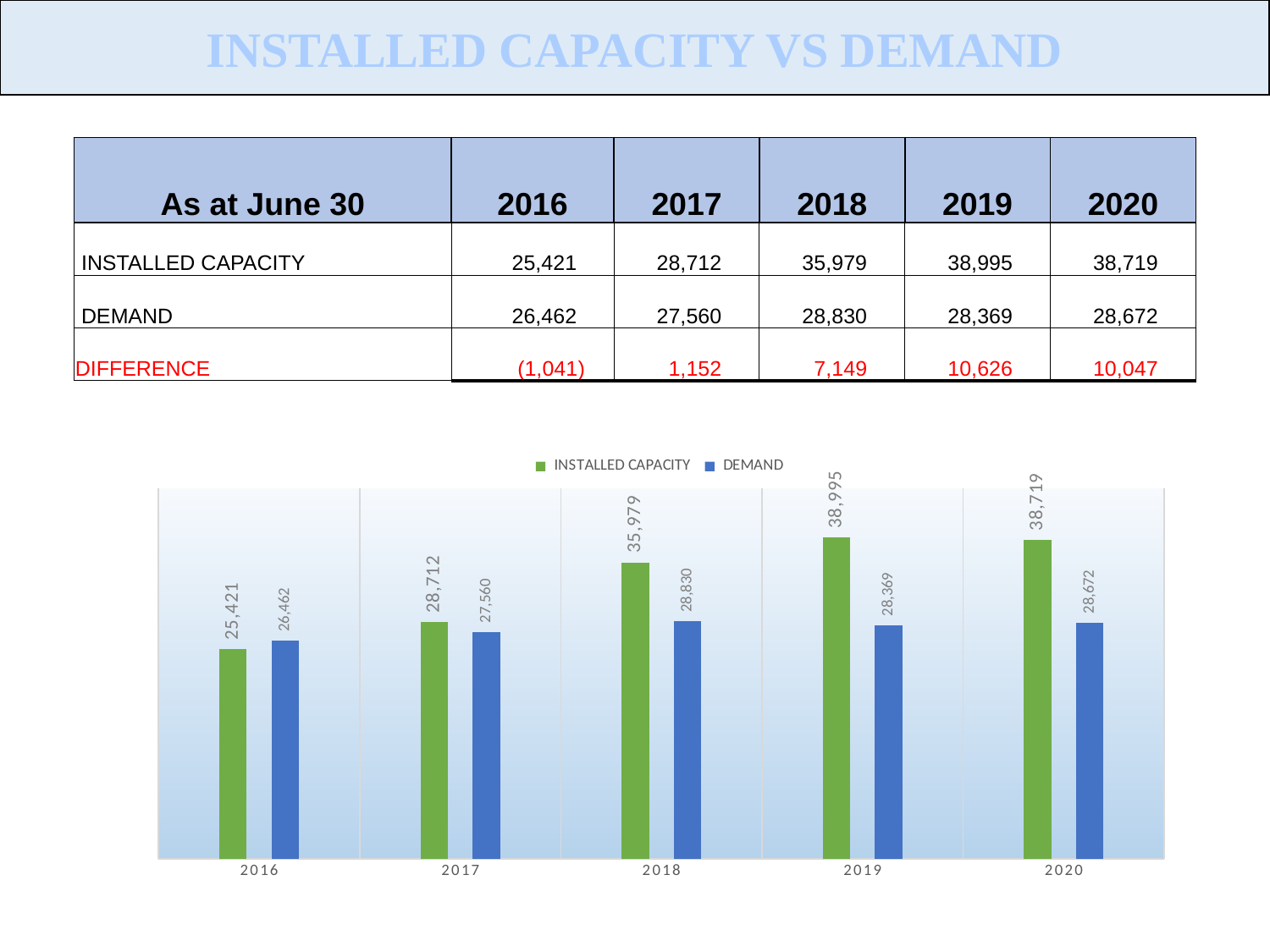
What type of chart is shown on the slide? Bar chart What is the difference between installed capacity and demand in 2019? 10,626 Does installed capacity rise or fall from 2016 to 2019 in the chart? Rise How many series does the chart legend list? 2 How many years are shown on the x axis of the chart? 5 Which year has the highest installed capacity in the chart? 2019 What is the installed capacity value for 2018 in the chart? 35,979 In 2016, which is larger: installed capacity or demand? Demand What is the difference between installed capacity in 2019 and 2020? 276 What is the demand value for 2020 in the chart? 28,672 Which year has the lowest demand in the chart? 2016 Which colour represents demand in the chart? Blue